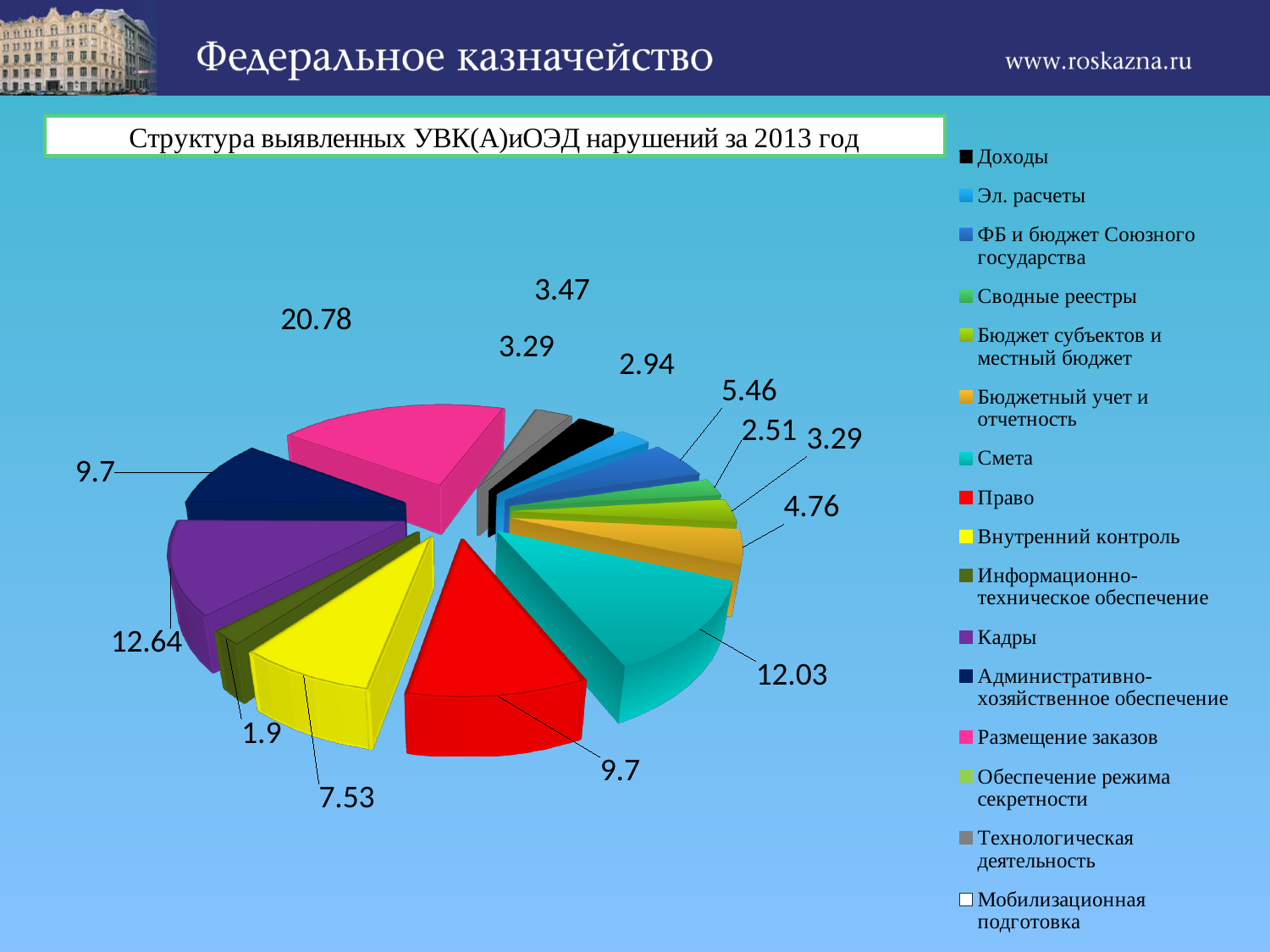
What is the value shown for Информационно-техническое обеспечение? 1.9 What is the difference between the values for Размещение заказов and Кадры? 8.14 What is the value shown for Смета? 12.03 Which category has the largest slice of the pie? Размещение заказов What kind of chart is shown on the slide? pie chart What is the value shown for Кадры? 12.64 What is the title of the chart? Структура выявленных УВК(А)иОЭД нарушений за 2013 год What is the value shown for Размещение заказов? 20.78 What is the value shown for Внутренний контроль? 7.53 Which is larger, the value for Кадры or the value for Смета? Кадры What is the value shown for Эл. расчеты? 2.94 What is the value shown for Право? 9.7